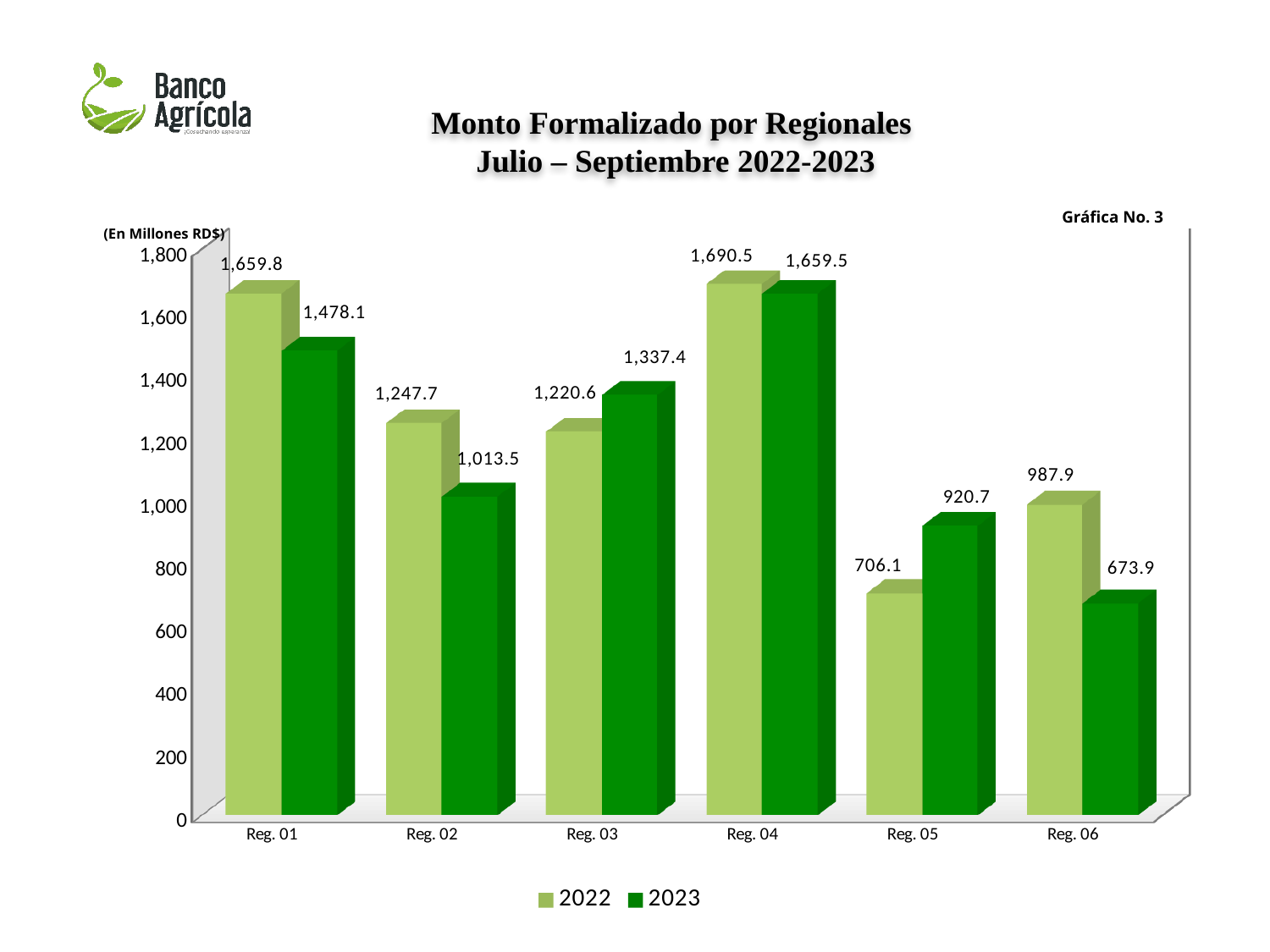
What is the difference between the 2022 and 2023 values for Reg. 06? 314.0 What kind of chart is shown on the slide? Bar chart What is the value for Reg. 03 in the 2023 series? 1,337.4 For Reg. 03, which series has the larger value, 2022 or 2023? 2023 Which region has the lowest value in the 2023 series? Reg. 06 Which region has the lowest value in the 2022 series? Reg. 05 What is the value for Reg. 05 in the 2023 series? 920.7 How many regions are shown on the x axis? 6 Which region has the highest value in the 2022 series? Reg. 04 How many series does the legend list? 2 What is the value for Reg. 01 in the 2022 series? 1,659.8 What is the difference between the 2023 and 2022 values for Reg. 05? 214.6